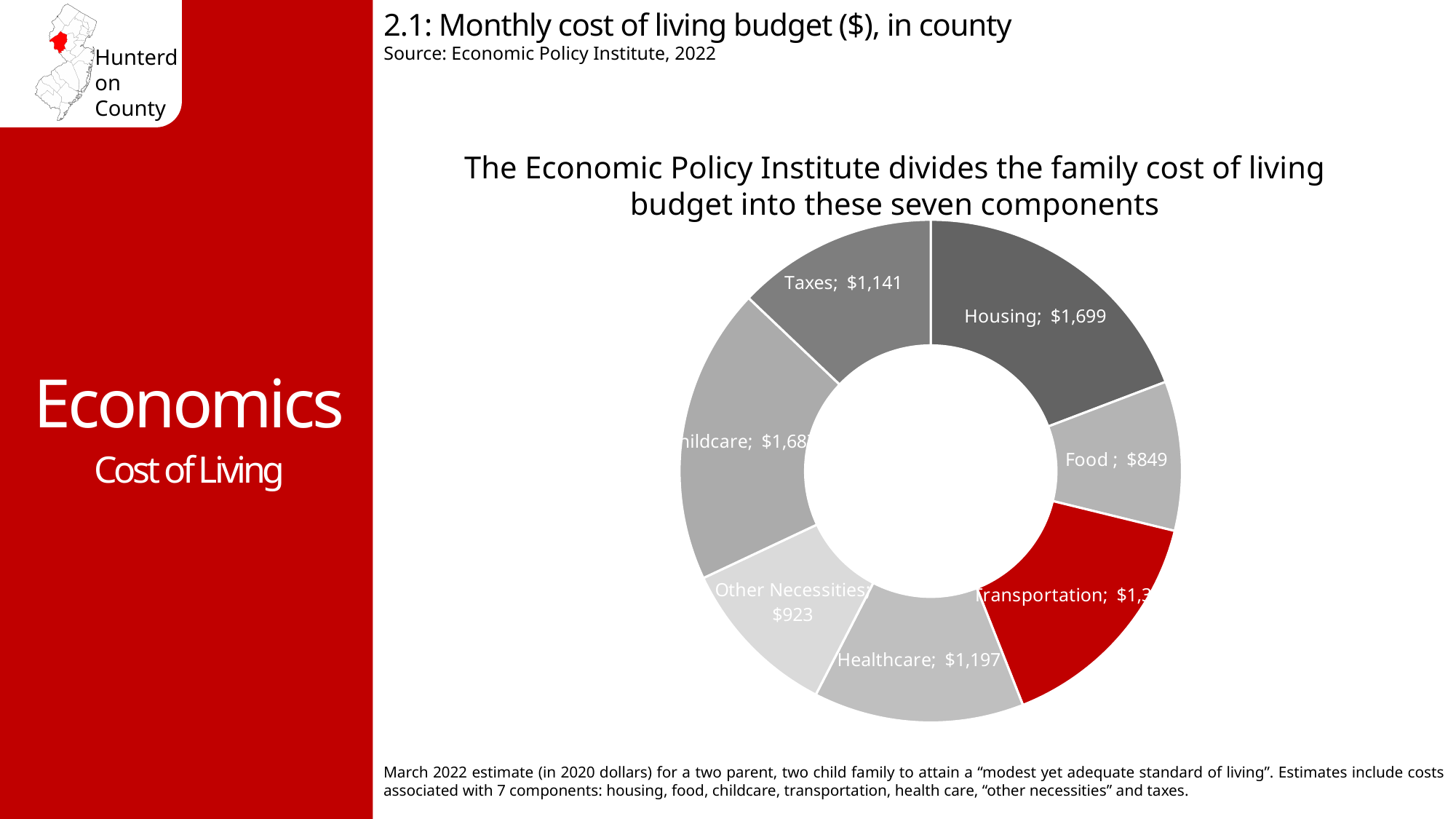
Which component is shown in red on the chart? Transportation What is the monthly housing cost shown on the chart? $1,699 What kind of chart is used to show the monthly cost of living budget? Donut (pie) chart What is the monthly healthcare cost shown on the chart? $1,197 What is the monthly cost for taxes shown on the chart? $1,141 Which is larger, the healthcare cost or the taxes cost? Healthcare What is the monthly cost for other necessities shown on the chart? $923 What is the monthly food cost shown on the chart? $849 Which component has the lowest monthly cost on the chart? Food What is the difference between the healthcare cost and the food cost? $348 How many components does the chart divide the monthly budget into? 7 What is the difference between the housing cost and the taxes cost? $558